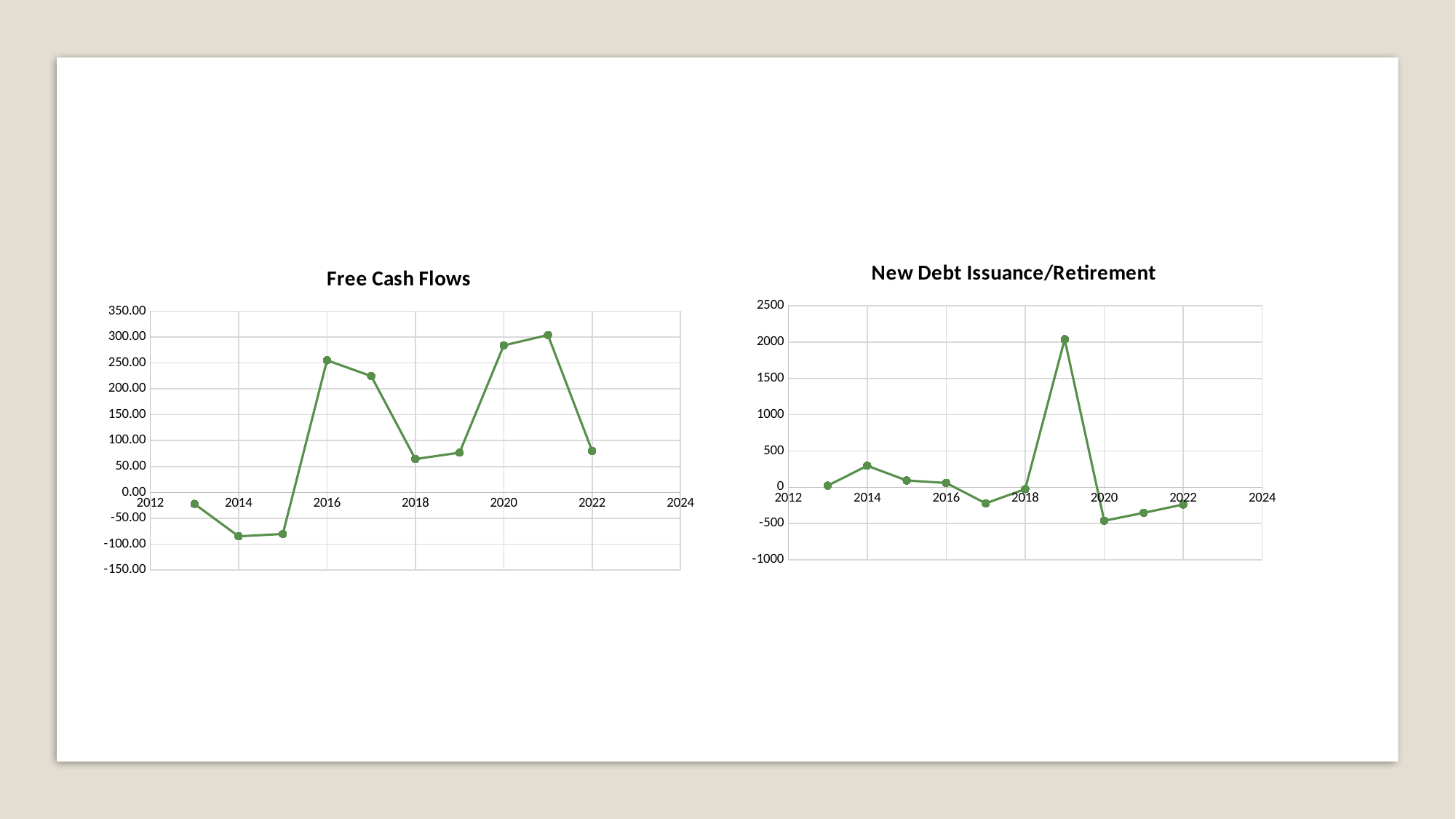
What kind of chart is the "Free Cash Flows" chart? line chart In the "Free Cash Flows" chart, which is larger, the value for 2017 or the value for 2018? 2017 In the "Free Cash Flows" chart, do the values rise or fall from 2021 to 2022? fall In the "Free Cash Flows" chart, is the value for 2016 greater or less than 200.00? greater What is the title of the chart on the right side of the slide? New Debt Issuance/Retirement How many data points are plotted on the "New Debt Issuance/Retirement" chart? 10 How many data points are plotted on the "Free Cash Flows" chart? 10 In the "Free Cash Flows" chart, is the value for 2014 greater or less than -50.00? less In the "New Debt Issuance/Retirement" chart, is the value for 2019 greater or less than 1500? greater In the "New Debt Issuance/Retirement" chart, which year has the highest value? 2019 In the "Free Cash Flows" chart, which year has the highest value? 2021 In the "New Debt Issuance/Retirement" chart, which year has the lowest value? 2020